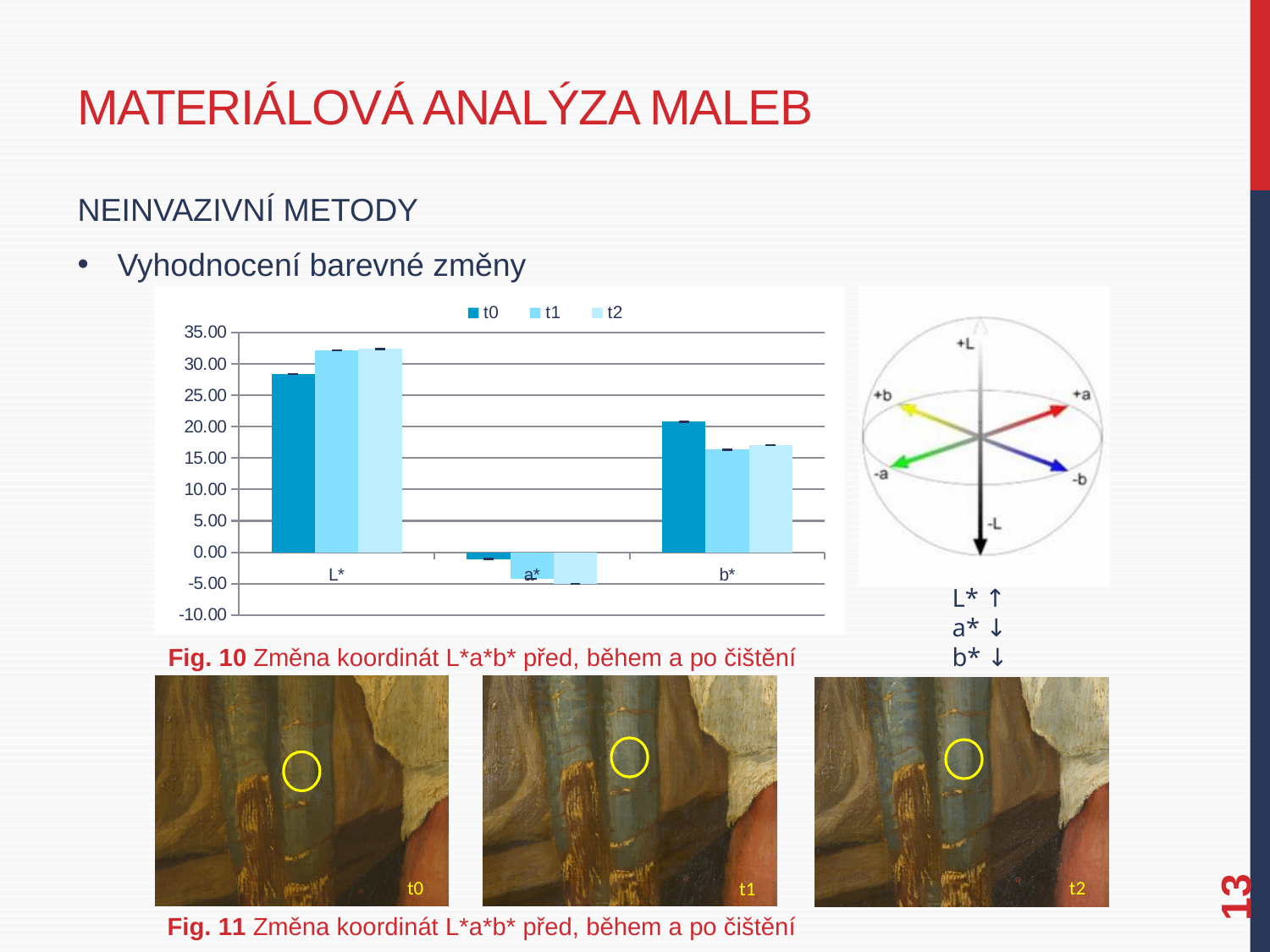
Is the value of t2 for a* greater or less than 0.00? less Is the value of t0 for L* greater or less than 25.00? greater Which category has the highest bars in the chart? L* Which category has the lowest bars in the chart? a* Is the value of t1 for L* greater or less than 30.00? greater How many series does the legend of the chart list? 3 What are the series names listed in the chart legend? t0, t1, t2 What kind of chart is shown in Fig. 10? bar chart How many categories are shown on the x axis of the chart? 3 For b*, which series has the highest bar? t0 For L*, which is larger: t0 or t1? t1